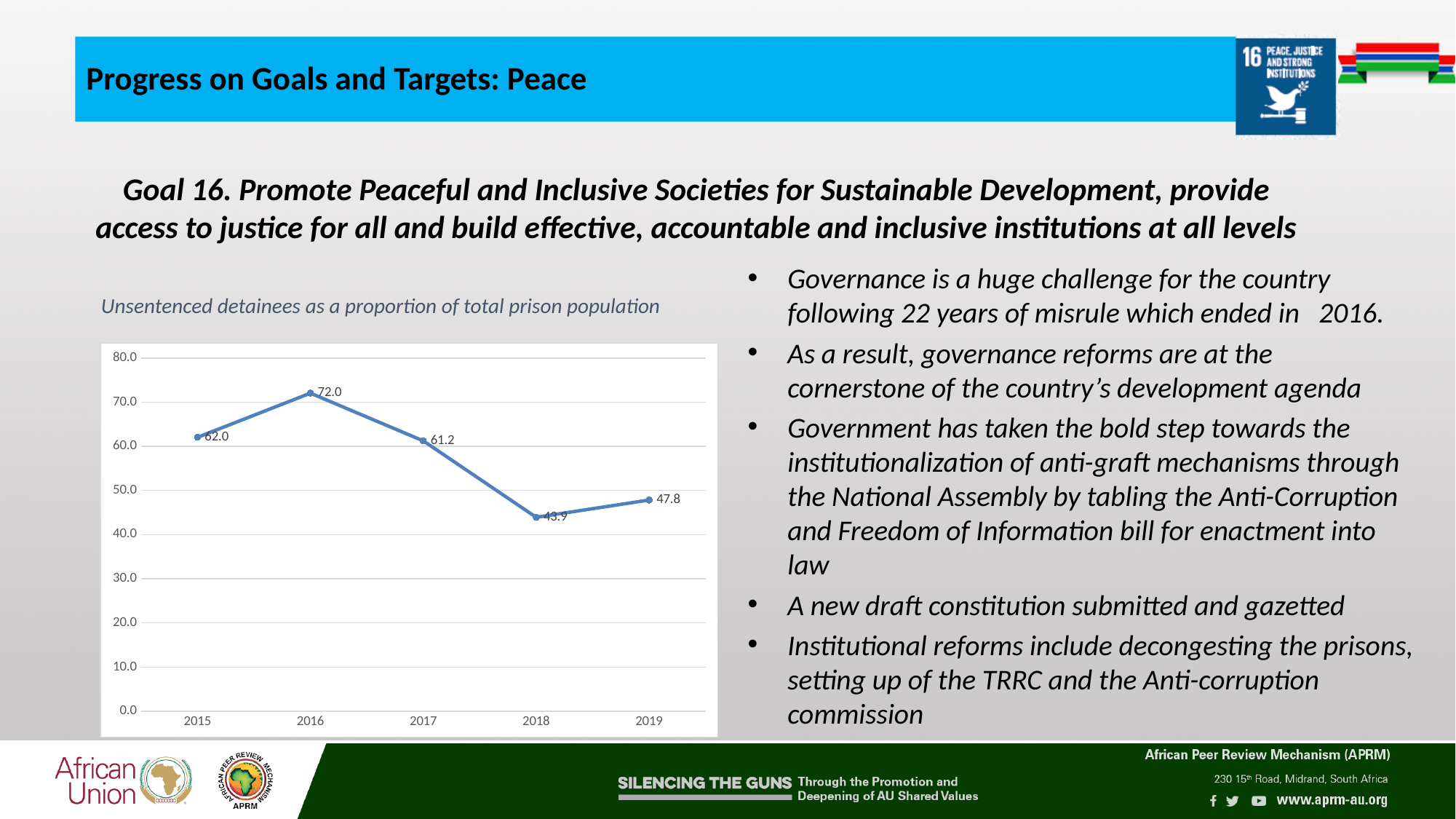
What is the value for 2015? 62.0 Which is larger, the value for 2015 or the value for 2017? 2015 What kind of chart is shown? Line chart Which year has the lowest value? 2018 What is the title of the chart? Unsentenced detainees as a proportion of total prison population Which year has the highest value? 2016 What is the value for 2016? 72.0 What is the value for 2019? 47.8 What is the difference between the values for 2016 and 2018? 28.1 What is the value for 2018? 43.9 How many years are plotted on the chart? 5 Does the value rise or fall from 2016 to 2018? Fall